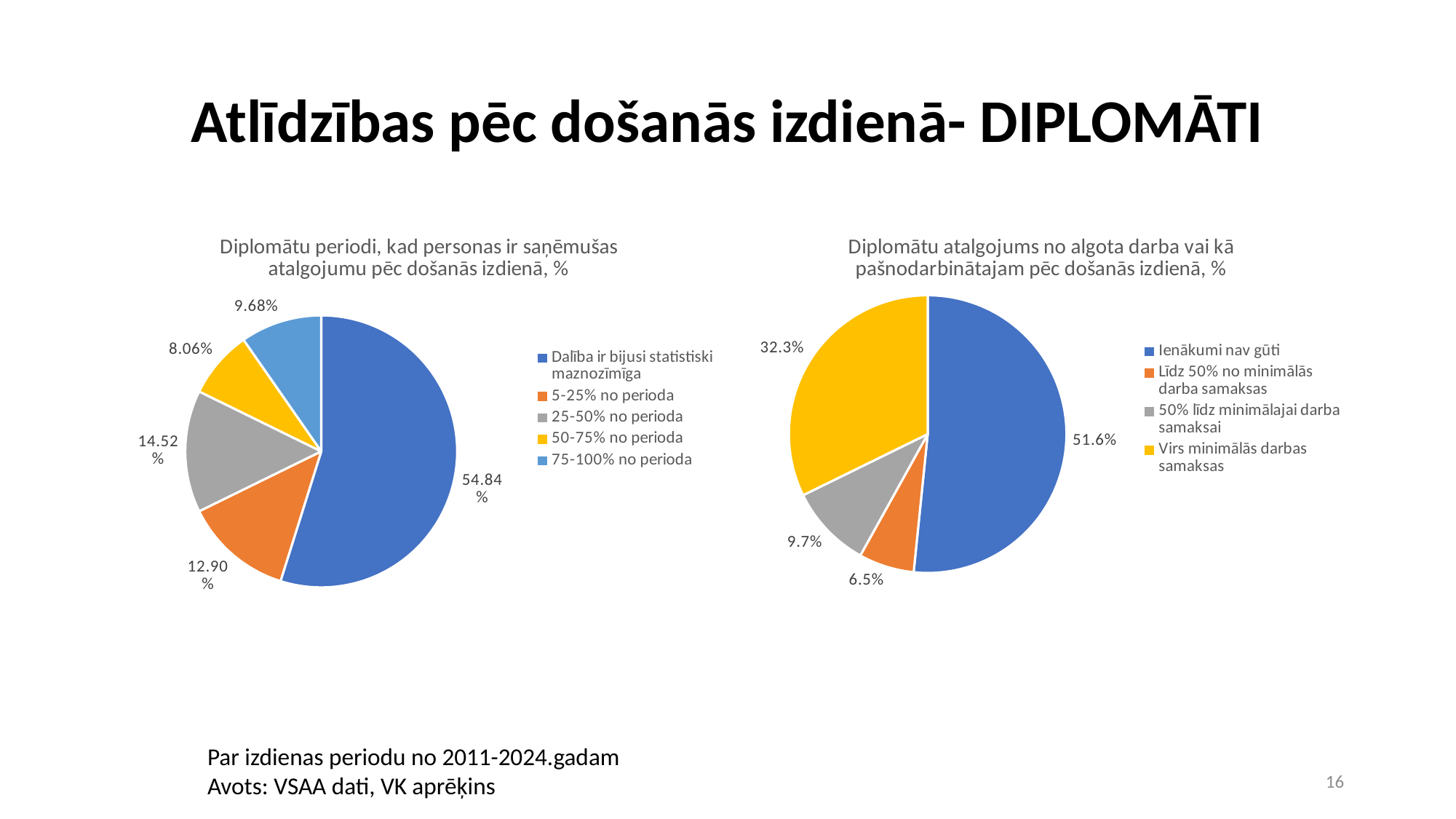
In the right pie chart, which is larger: '50% līdz minimālajai darba samaksai' or 'Līdz 50% no minimālās darba samaksas'? 50% līdz minimālajai darba samaksai What type of chart is used for both charts on the slide? Pie chart In the right pie chart, which category has the smallest slice? Līdz 50% no minimālās darba samaksas In the right pie chart, what share is shown for 'Ienākumi nav gūti'? 51.6% In the left pie chart, which category has the largest slice? Dalība ir bijusi statistiski maznozīmīga In the left pie chart, what share is labelled for the slice 'Dalība ir bijusi statistiski maznozīmīga'? 54.84% In the left pie chart, what share is shown for '25-50% no perioda'? 14.52% In the right pie chart, what is the difference between the shares for 'Ienākumi nav gūti' and 'Virs minimālās darbas samaksas'? 19.3% In the right pie chart, what share is shown for 'Virs minimālās darbas samaksas'? 32.3% In the left pie chart, what is the difference between the shares for '25-50% no perioda' and '5-25% no perioda'? 1.62% In the left pie chart, which category has the smallest slice? 50-75% no perioda In the left pie chart, how many categories does the legend list? 5